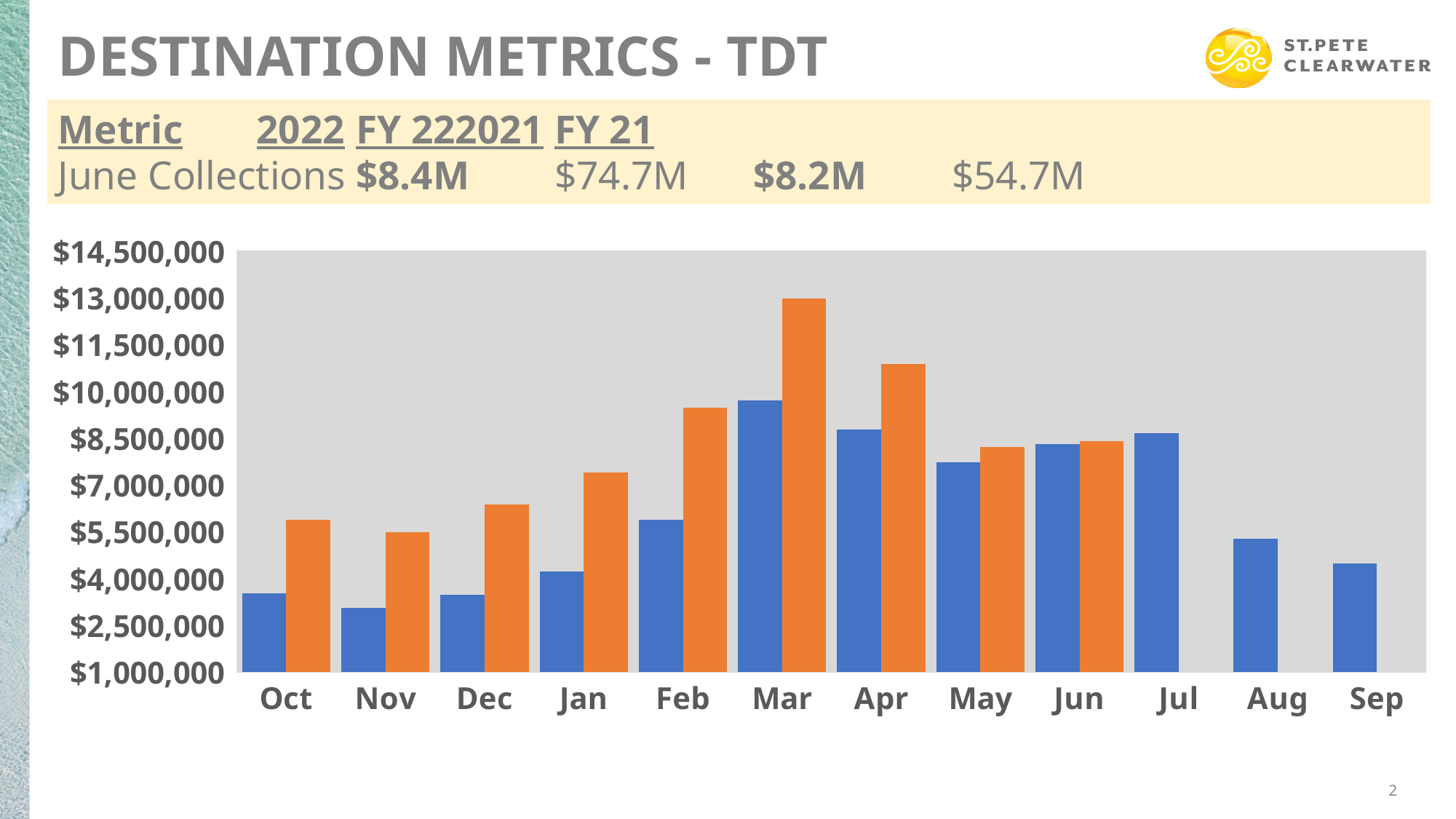
Which month has the tallest orange bar in the chart? Mar Is the orange bar for Apr greater or less than $10,000,000? greater Is the blue bar for Jan greater or less than $5,500,000? less Is the orange bar for Mar greater or less than $11,500,000? greater Do the orange bars rise or fall from Oct to Mar? rise Which months in the chart have only a blue bar and no orange bar? Jul, Aug, Sep What kind of chart is shown on the slide? bar chart How many month categories are shown on the x axis of the chart? 12 Which is larger, the orange bar for Mar or the orange bar for Apr? Mar Which month has the shortest blue bar in the chart? Nov